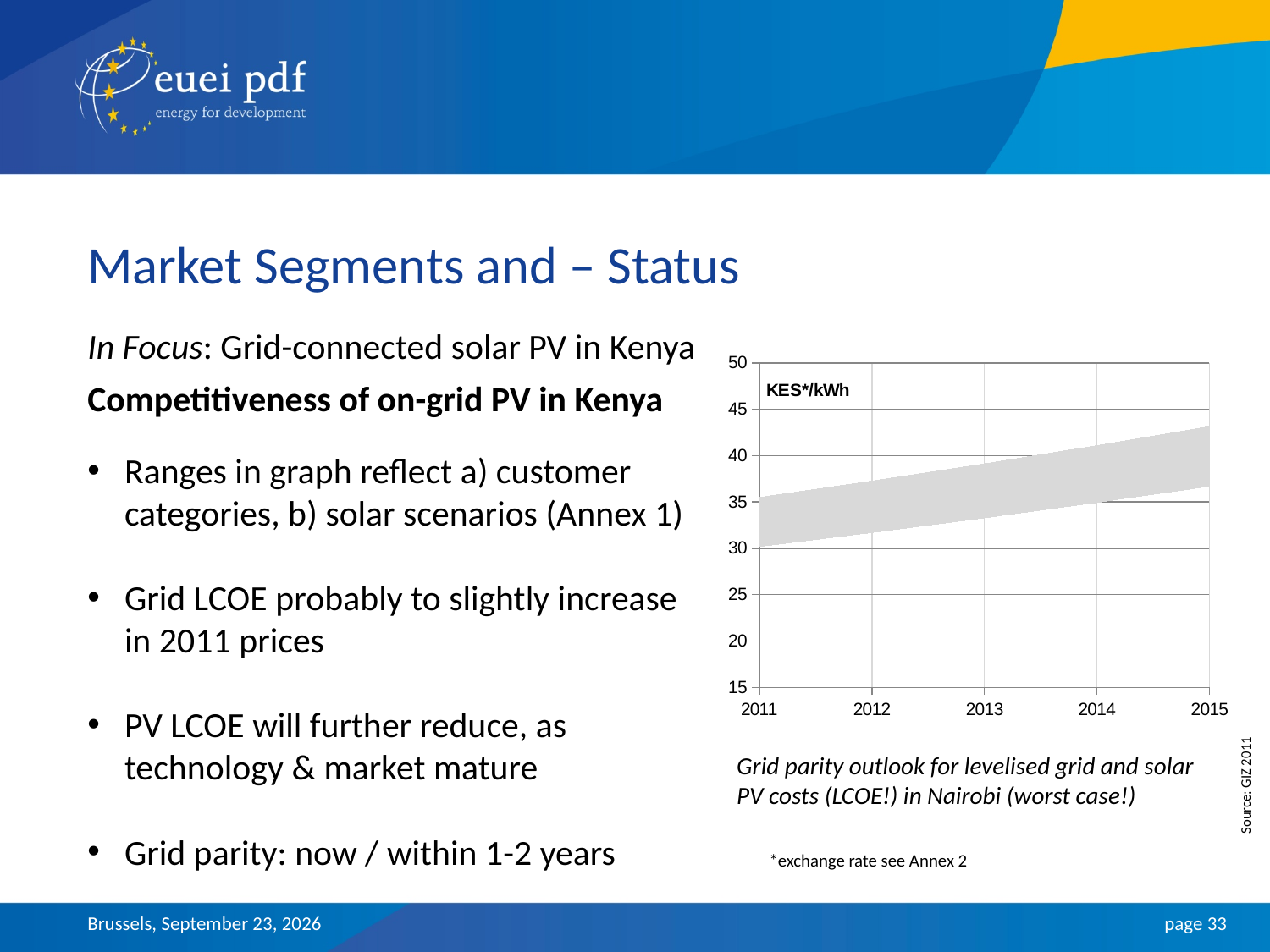
Is the lower edge of the shaded band in 2015 greater or less than 35? greater Is the lower edge of the shaded band in 2013 greater or less than 35? less What unit label is printed inside the chart area? KES*/kWh What kind of chart is shown on the slide? area chart What is the first year shown on the x axis of the chart? 2011 How many years are marked along the x axis of the chart? 5 Is the lower edge of the shaded band in 2012 greater or less than 30? greater What is the highest value shown on the y axis of the chart? 50 What source is cited for the chart? GIZ 2011 Does the shaded band in the chart rise or fall from 2011 to 2015? rise